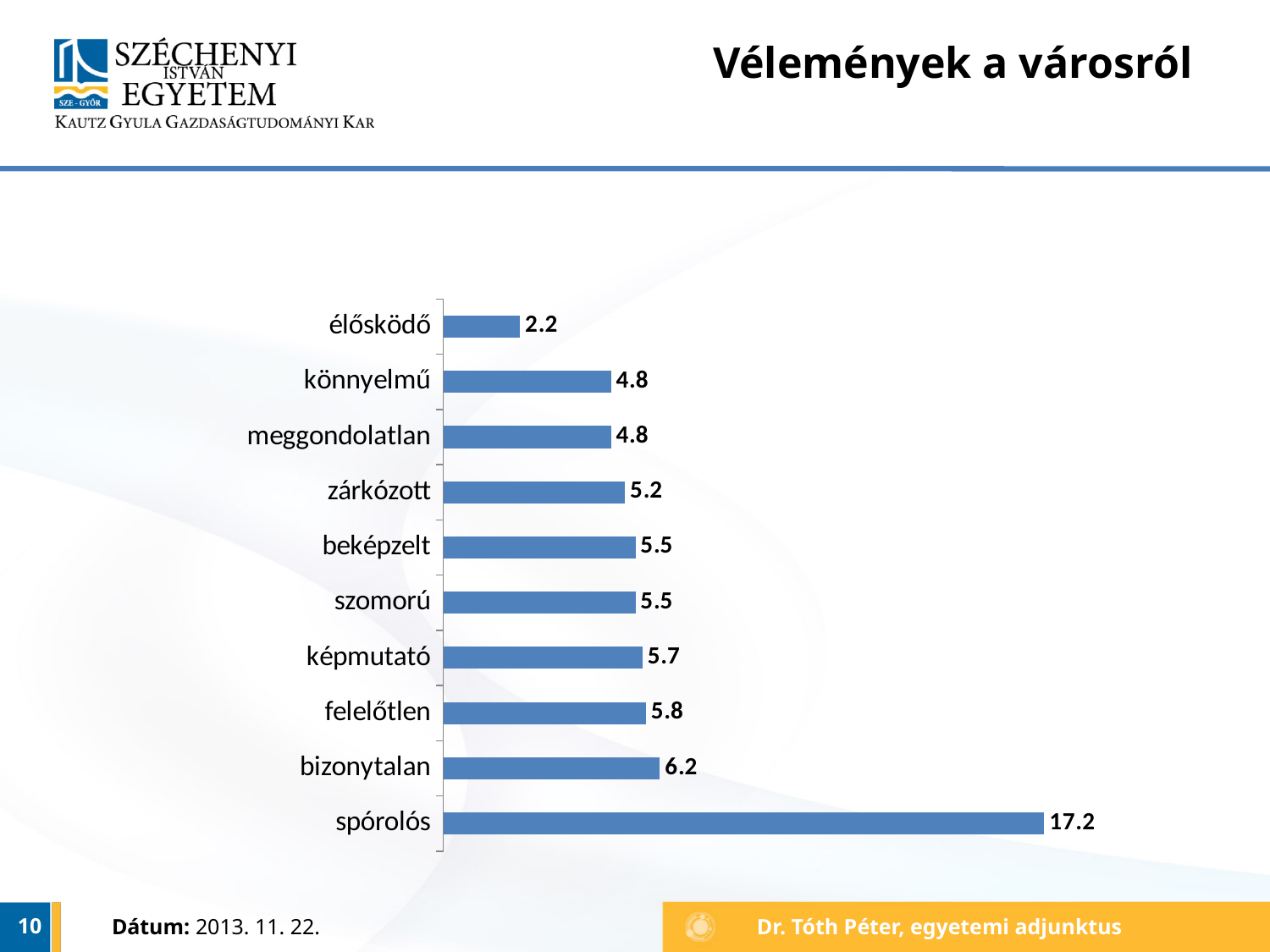
What is the value for spórolós? 17.2 What is the value for élősködő? 2.2 Which category has the lowest value? élősködő What kind of chart is shown on the slide? bar chart What is the value for zárkózott? 5.2 Which category has the highest value? spórolós How many categories are shown in the chart? 10 What is the value for bizonytalan? 6.2 Which is larger, the value for képmutató or the value for könnyelmű? képmutató What is the difference between the values for felelőtlen and élősködő? 3.6 What is the title of the slide containing the chart? Vélemények a városról What is the difference between the values for spórolós and bizonytalan? 11.0